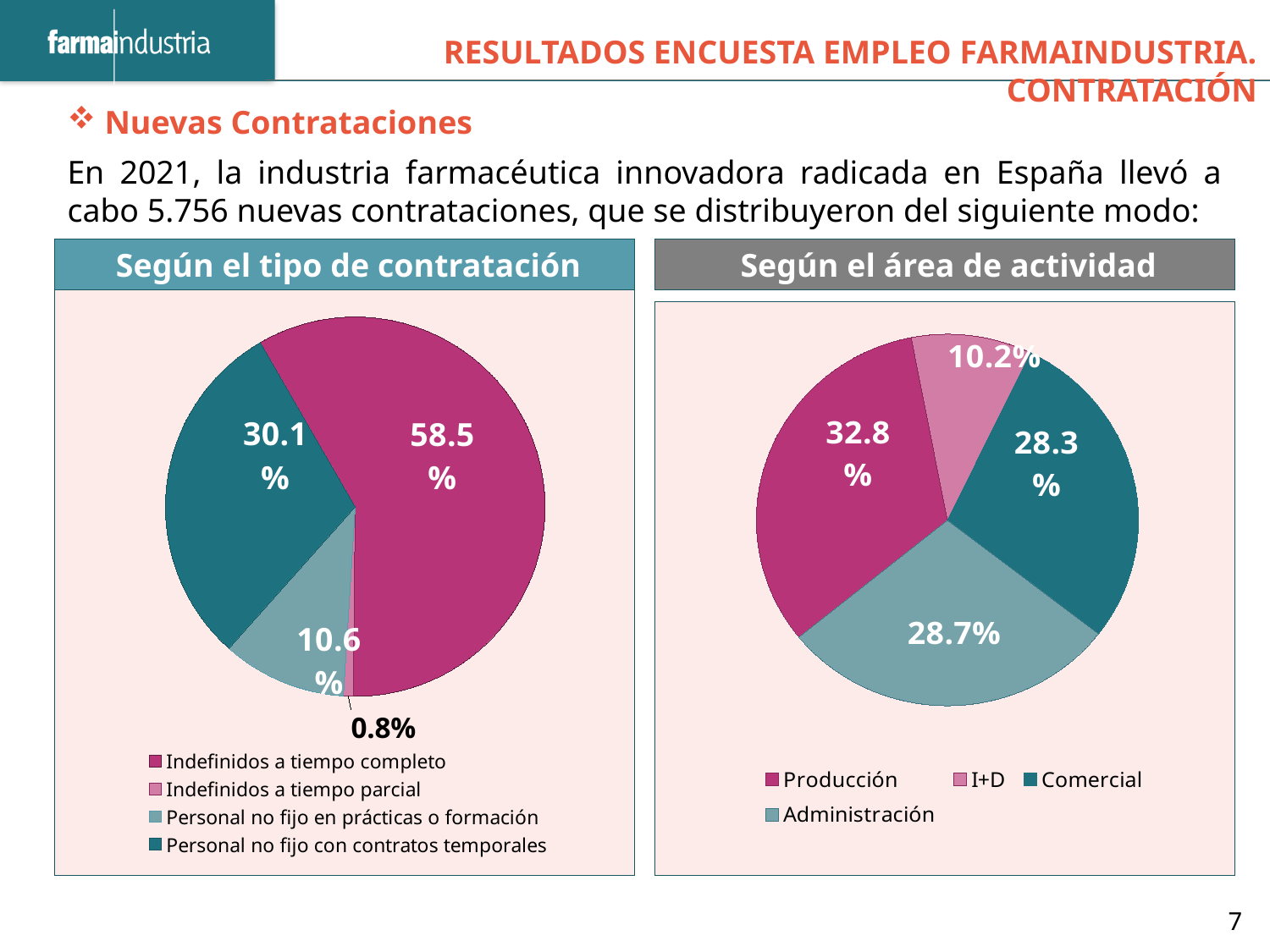
In the 'Según el tipo de contratación' chart, what is the difference between 'Indefinidos a tiempo completo' and 'Personal no fijo con contratos temporales'? 28.4% In the 'Según el tipo de contratación' chart, how many categories does the legend list? 4 In the 'Según el área de actividad' chart, which is larger, 'Producción' or 'Comercial'? Producción In the 'Según el tipo de contratación' chart, what share is 'Personal no fijo con contratos temporales'? 30.1% What is the title of the chart on the right side of the slide? Según el área de actividad In the 'Según el tipo de contratación' chart, what share is 'Indefinidos a tiempo completo'? 58.5% What type of chart is 'Según el tipo de contratación'? Pie chart In the 'Según el área de actividad' chart, which area has the largest share? Producción In the 'Según el tipo de contratación' chart, which category has the smallest share? Indefinidos a tiempo parcial In the 'Según el área de actividad' chart, what share is 'Producción'? 32.8% In the 'Según el área de actividad' chart, what is the difference between 'Administración' and 'I+D'? 18.5% In the 'Según el área de actividad' chart, what share is 'I+D'? 10.2%